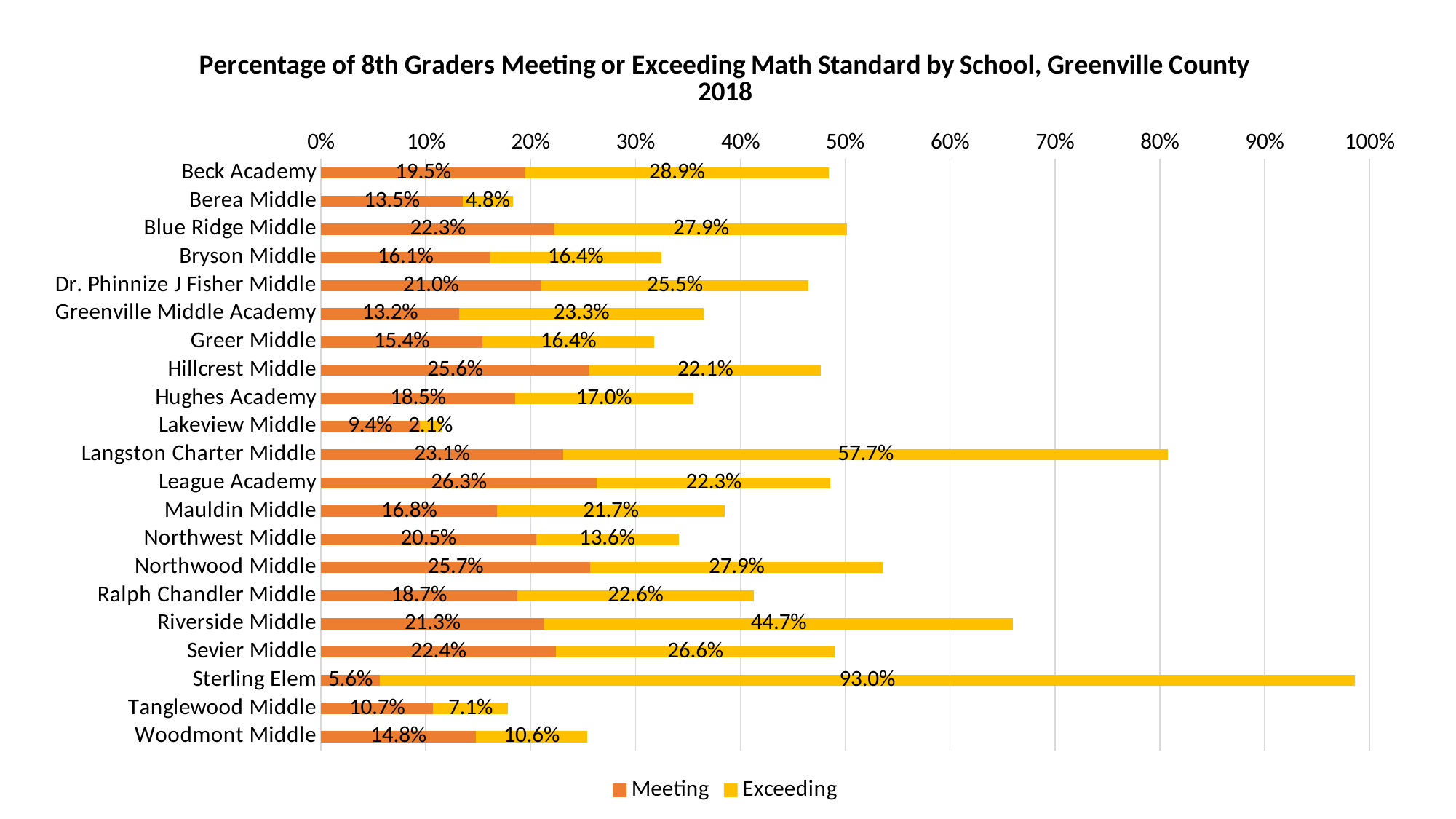
How many series does the legend list? 2 Which school has the highest Exceeding value? Sterling Elem What is the Exceeding value for Langston Charter Middle? 57.7% What is the difference between the Exceeding and Meeting values for Riverside Middle? 23.4% Which is larger, the Exceeding value for Beck Academy or the Exceeding value for Blue Ridge Middle? Beck Academy What is the Meeting value for Hillcrest Middle? 25.6% What is the total of the stacked bar for Sterling Elem? 98.6% Which school has the lowest Exceeding value? Lakeview Middle Which school has the highest Meeting value? League Academy What type of chart is shown on the slide? Stacked bar chart How many schools are shown in the chart? 21 Which colour represents the Exceeding series? Yellow